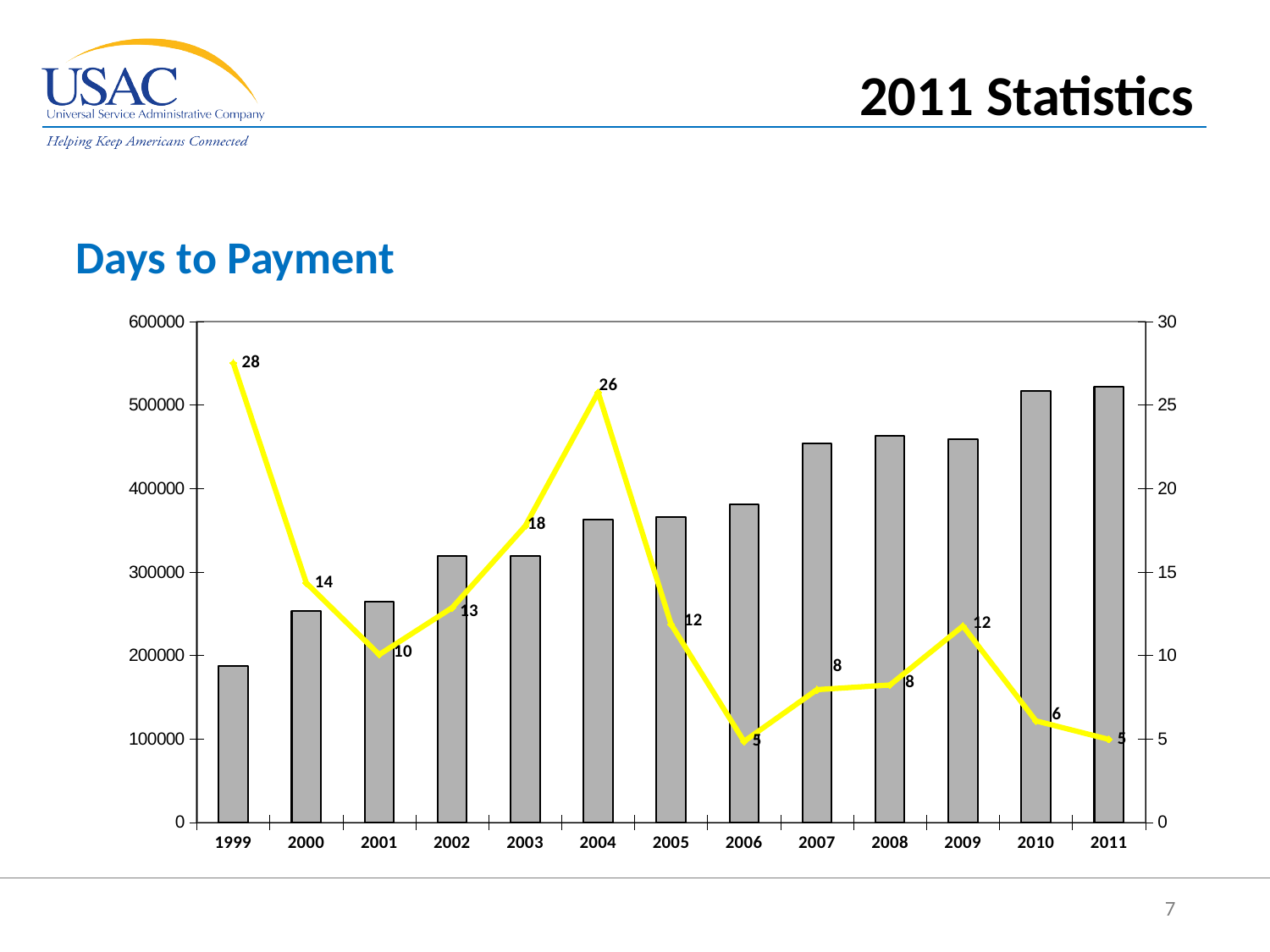
What is the days-to-payment value shown on the line for 2011? 5 What is the days-to-payment value shown on the line for 2004? 26 What is the days-to-payment value shown on the line for 1999? 28 Which year has the larger line value, 2000 or 2009? 2000 What is the days-to-payment value shown on the line for 2003? 18 How many years are shown on the x axis? 13 Is the bar value for 2011 greater or less than 500000? greater Which year has the highest days-to-payment value on the line? 1999 Is the bar value for 1999 greater or less than 200000? less Do the bar values generally rise or fall from 1999 to 2011? rise What is the difference between the line values for 1999 and 2004? 2 What is the title of the chart? Days to Payment